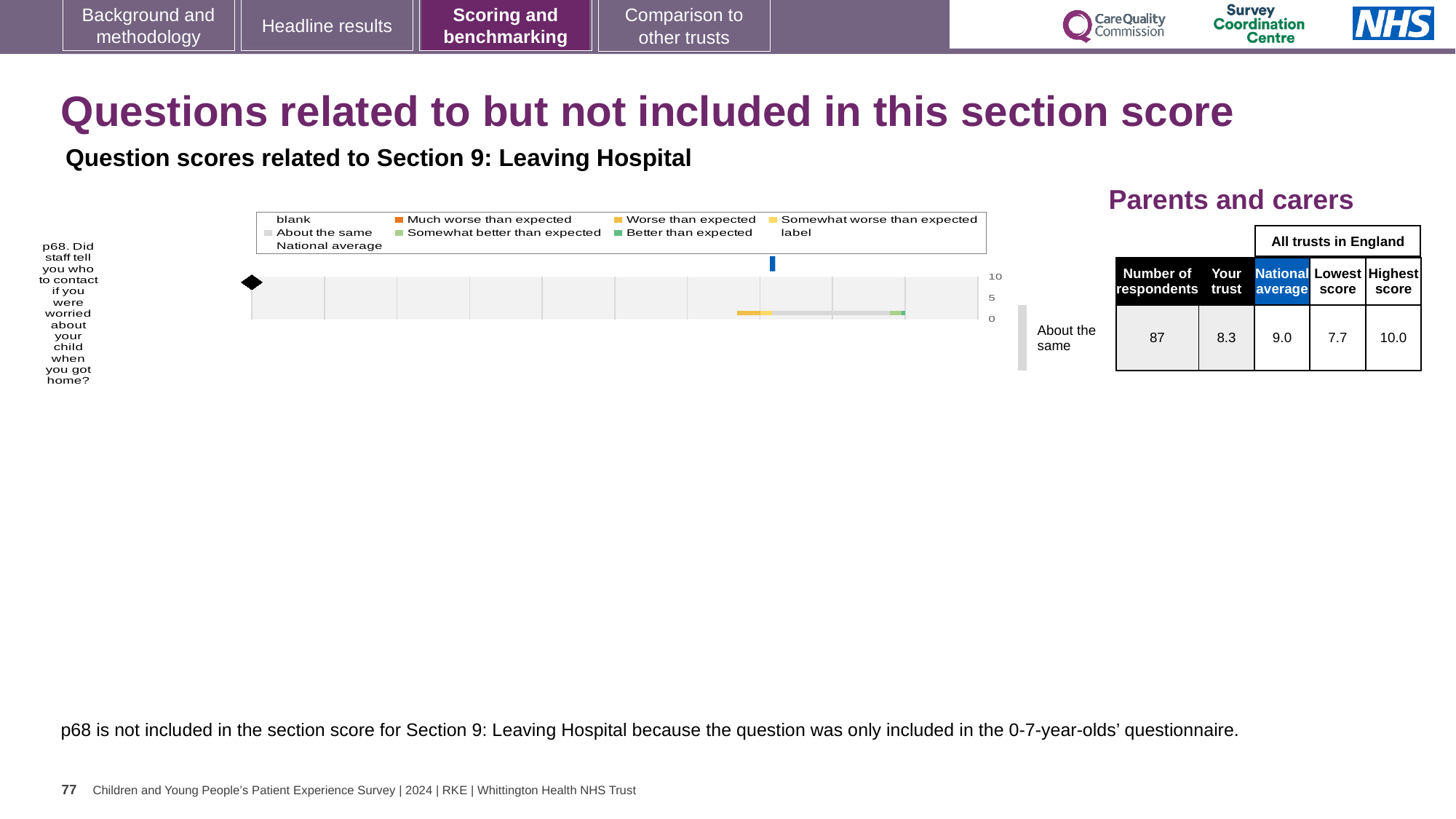
What is the lowest score across all trusts in England for p68? 7.7 For p68, which is larger: the trust's score or the national average? National average How many questions are plotted in the chart? 1 How many respondents answered p68 for this trust? 87 What benchmark category is the trust's p68 score placed in, as labelled next to the chart? About the same For p68, what is the difference between the national average and the trust's score? 0.7 What kind of chart is used to show the p68 question score? bar chart What is the national average score for p68 shown in the table beside the chart? 9.0 What is the 'Your trust' score for p68 shown in the table beside the chart? 8.3 Which question is plotted in the chart? p68. Did staff tell you who to contact if you were worried about your child when you got home? What is the highest score across all trusts in England for p68? 10.0 For p68, what is the difference between the highest and lowest scores across all trusts in England? 2.3